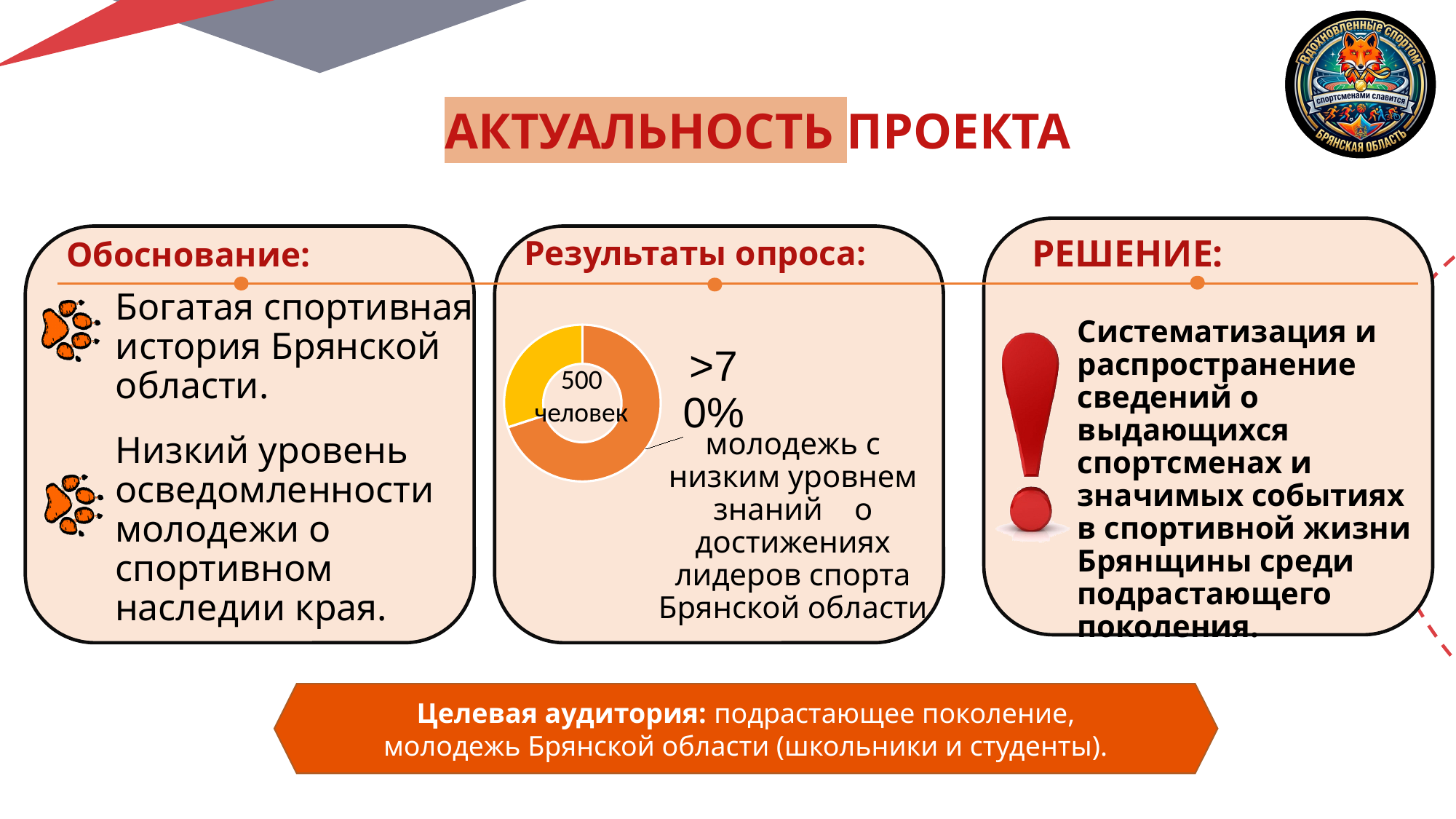
How many slices does the donut chart in the "Результаты опроса" box have? 2 Which slice of the donut chart is larger, the orange one or the yellow one? The orange one What text is printed in the centre of the donut chart? 500 человек What kind of chart is shown in the "Результаты опроса" box? Pie (donut) chart Which colour is used for the smaller slice of the donut chart? Yellow Is the orange slice of the donut chart greater or less than half of the whole? greater According to the label on the donut chart, what group does the >70% slice represent? Молодежь с низким уровнем знаний о достижениях лидеров спорта Брянской области What share is printed next to the orange slice of the donut chart? >70%